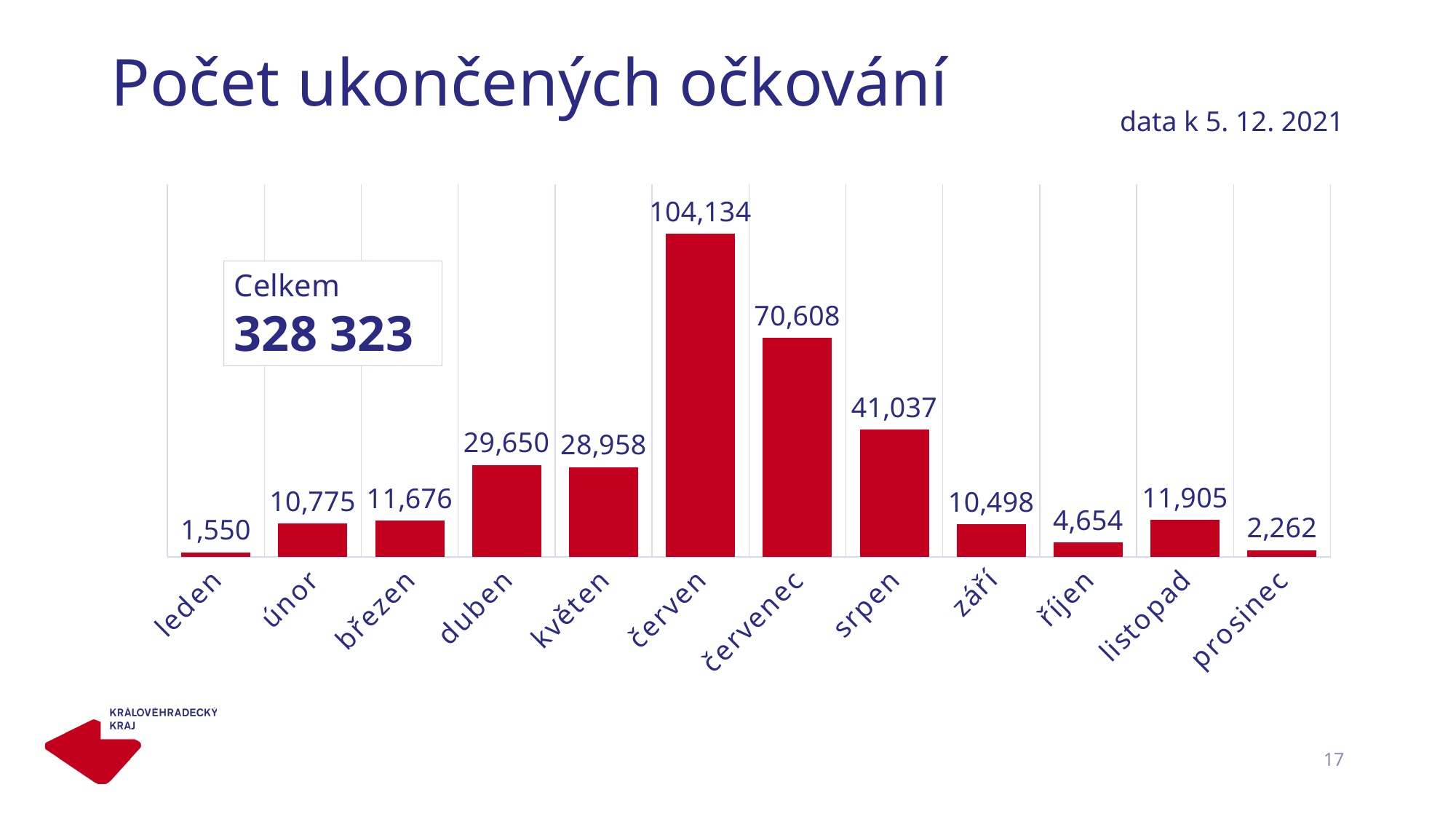
What is the difference between the values for červen and červenec? 33,526 How many months are shown on the x axis? 12 What kind of chart is shown on the slide? bar chart Which is larger, the value for říjen or the value for prosinec? říjen Which is larger, the value for červenec or the value for srpen? červenec What is the value for leden? 1,550 What is the value for listopad? 11,905 What total (Celkem) is shown in the box on the chart? 328 323 Which month has the highest value? červen What is the value for červen? 104,134 What is the difference between the values for srpen and září? 30,539 Which month has the lowest value? leden